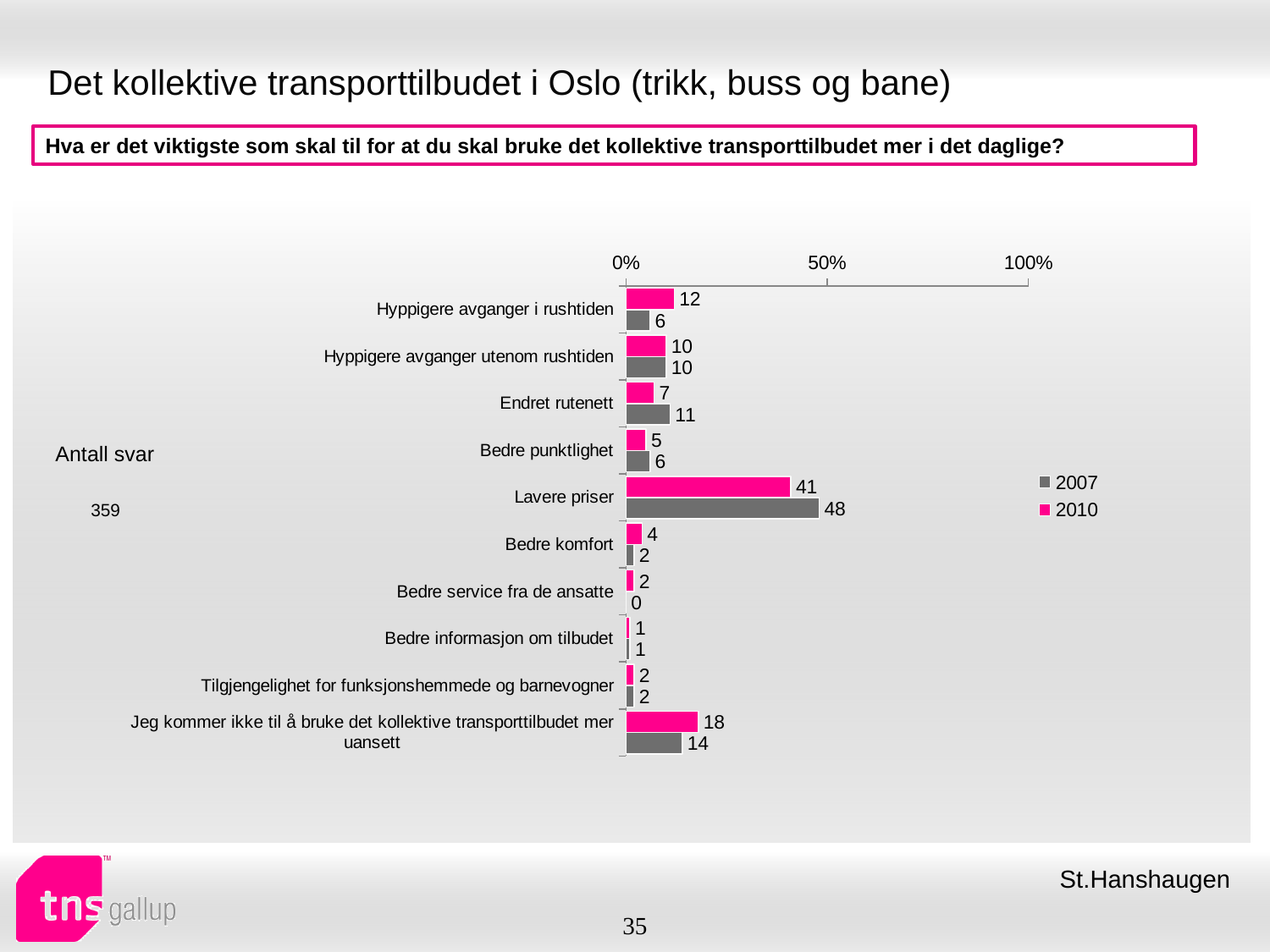
Is the 2007 value for "Lavere priser" greater or less than 50%? less What is the 2007 value for "Lavere priser"? 48 What is the 2010 value for "Hyppigere avganger i rushtiden"? 12 Which category has the lowest 2007 value? Bedre service fra de ansatte What is the 2010 value for "Jeg kommer ikke til å bruke det kollektive transporttilbudet mer uansett"? 18 What is the difference between the 2007 and 2010 values for "Lavere priser"? 7 What kind of chart is shown on the slide? Bar chart Which category has the highest 2010 value? Lavere priser How many categories are shown on the chart? 10 What is the 2007 value for "Endret rutenett"? 11 How many series does the legend list? 2 Which is larger for "Hyppigere avganger i rushtiden": the 2007 value or the 2010 value? 2010